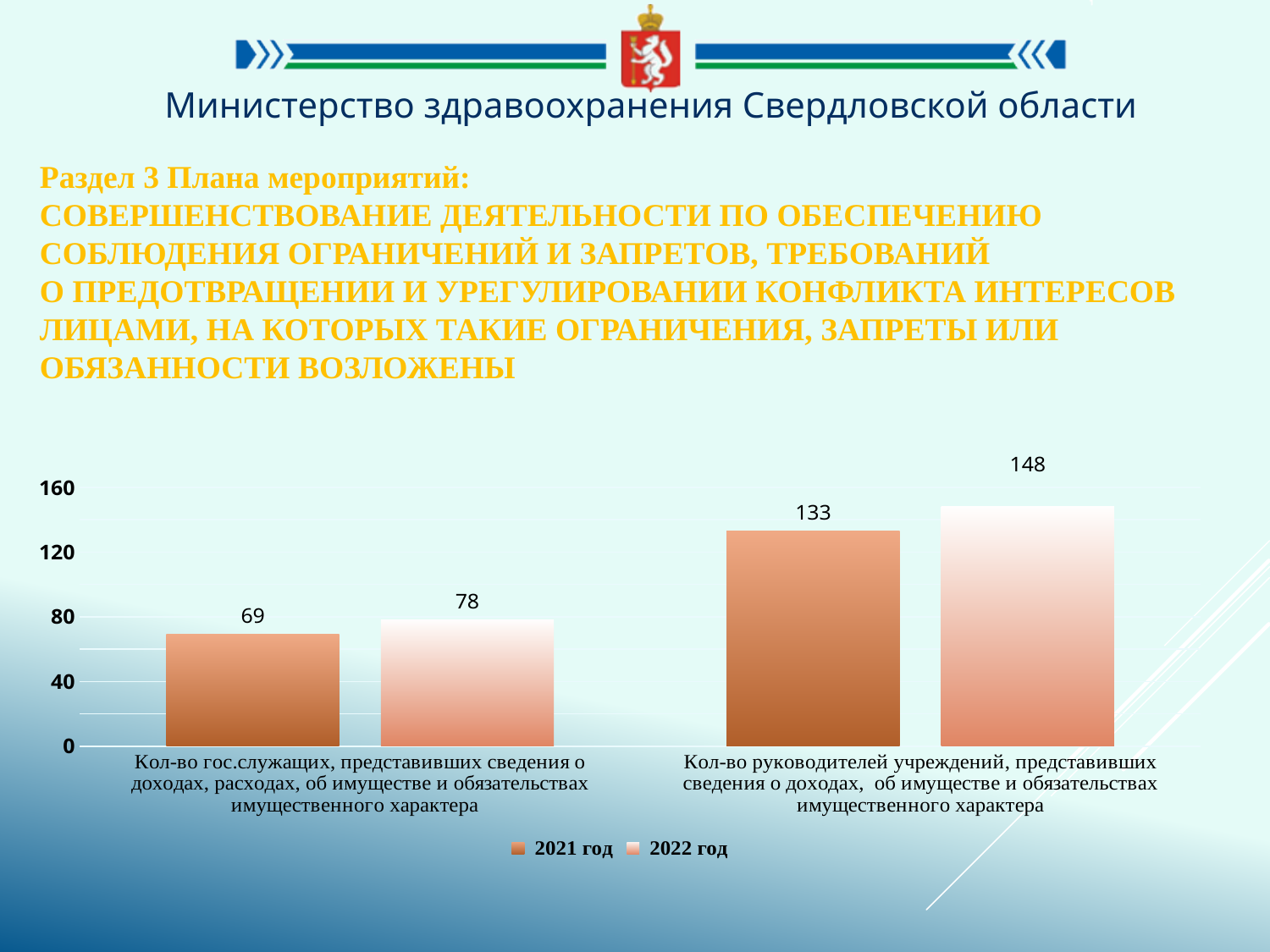
How many categories are shown on the x axis of the chart? 2 What is the difference between the 2022 год and 2021 год values for 'Кол-во руководителей учреждений'? 15 What is the difference between the 2022 год and 2021 год values for 'Кол-во гос.служащих'? 9 How many series does the legend list? 2 Which bar has the highest value on the chart? 2022 год for Кол-во руководителей учреждений (148) What is the value for 2021 год for the category 'Кол-во гос.служащих, представивших сведения о доходах, расходах, об имуществе и обязательствах имущественного характера'? 69 Which is larger: the 2021 год value for 'Кол-во гос.служащих' or the 2021 год value for 'Кол-во руководителей учреждений'? Кол-во руководителей учреждений (133) What is the value for 2022 год for the category 'Кол-во руководителей учреждений, представивших сведения о доходах, об имуществе и обязательствах имущественного характера'? 148 Which bar has the lowest value on the chart? 2021 год for Кол-во гос.служащих (69) What is the value for 2021 год for the category 'Кол-во руководителей учреждений, представивших сведения о доходах, об имуществе и обязательствах имущественного характера'? 133 What kind of chart is shown on the slide? Bar chart What is the value for 2022 год for the category 'Кол-во гос.служащих, представивших сведения о доходах, расходах, об имуществе и обязательствах имущественного характера'? 78